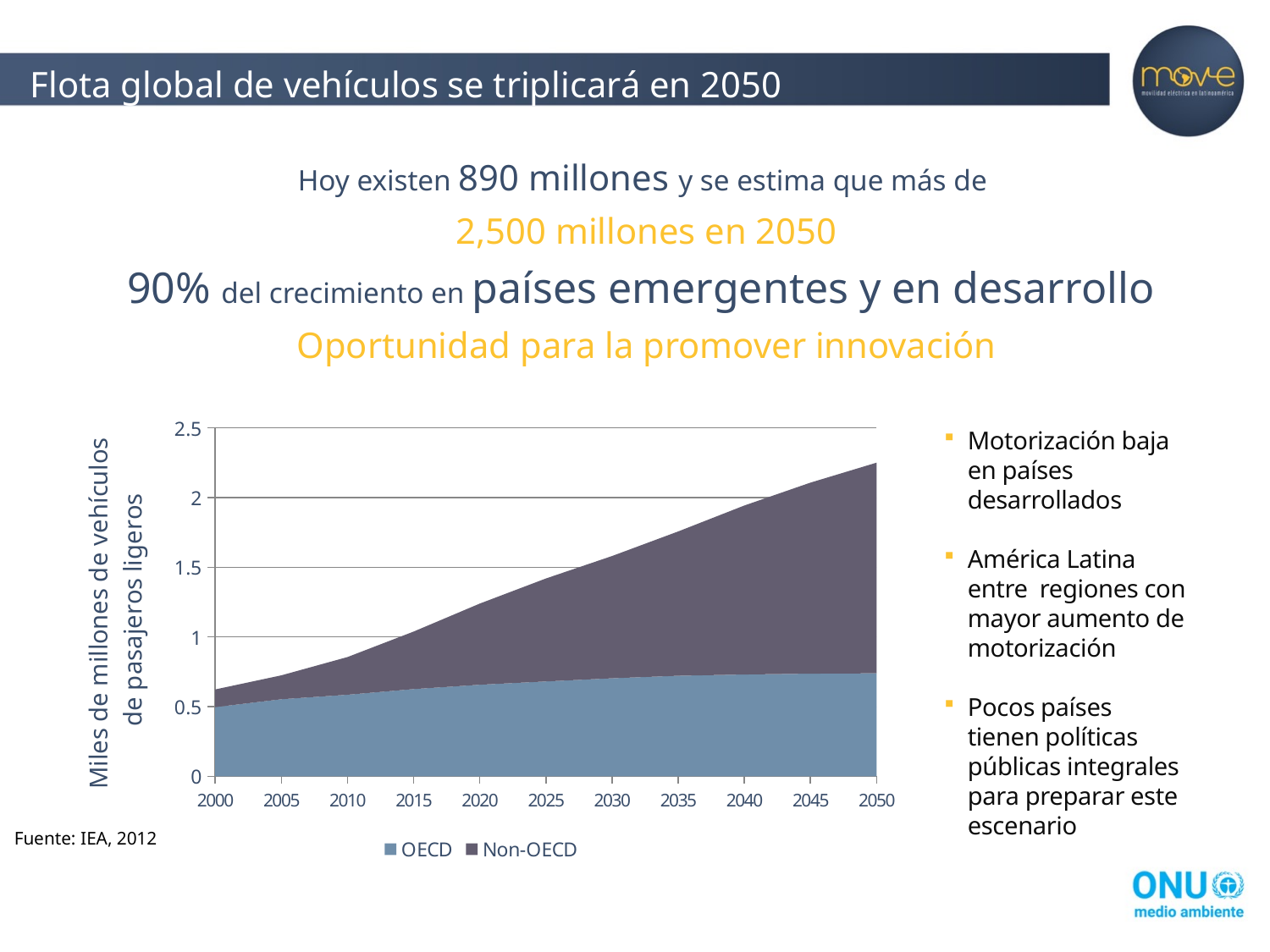
Does the total number of vehicles rise or fall from 2000 to 2050 in the chart? Rise Is the OECD value in 2050 greater or less than 0.5? greater Is the total value (OECD plus Non-OECD) in 2010 greater or less than 1? less What is the title of the vertical axis of the chart? Miles de millones de vehículos de pasajeros ligeros What kind of chart is shown on the slide? Stacked area chart In 2000, which series is larger, OECD or Non-OECD? OECD Is the total value (OECD plus Non-OECD) in 2000 greater or less than 1? less In 2050, which series is larger, OECD or Non-OECD? Non-OECD How many series does the chart legend list? 2 How many year labels are shown along the x axis of the chart? 11 Which two series are listed in the chart legend? OECD and Non-OECD